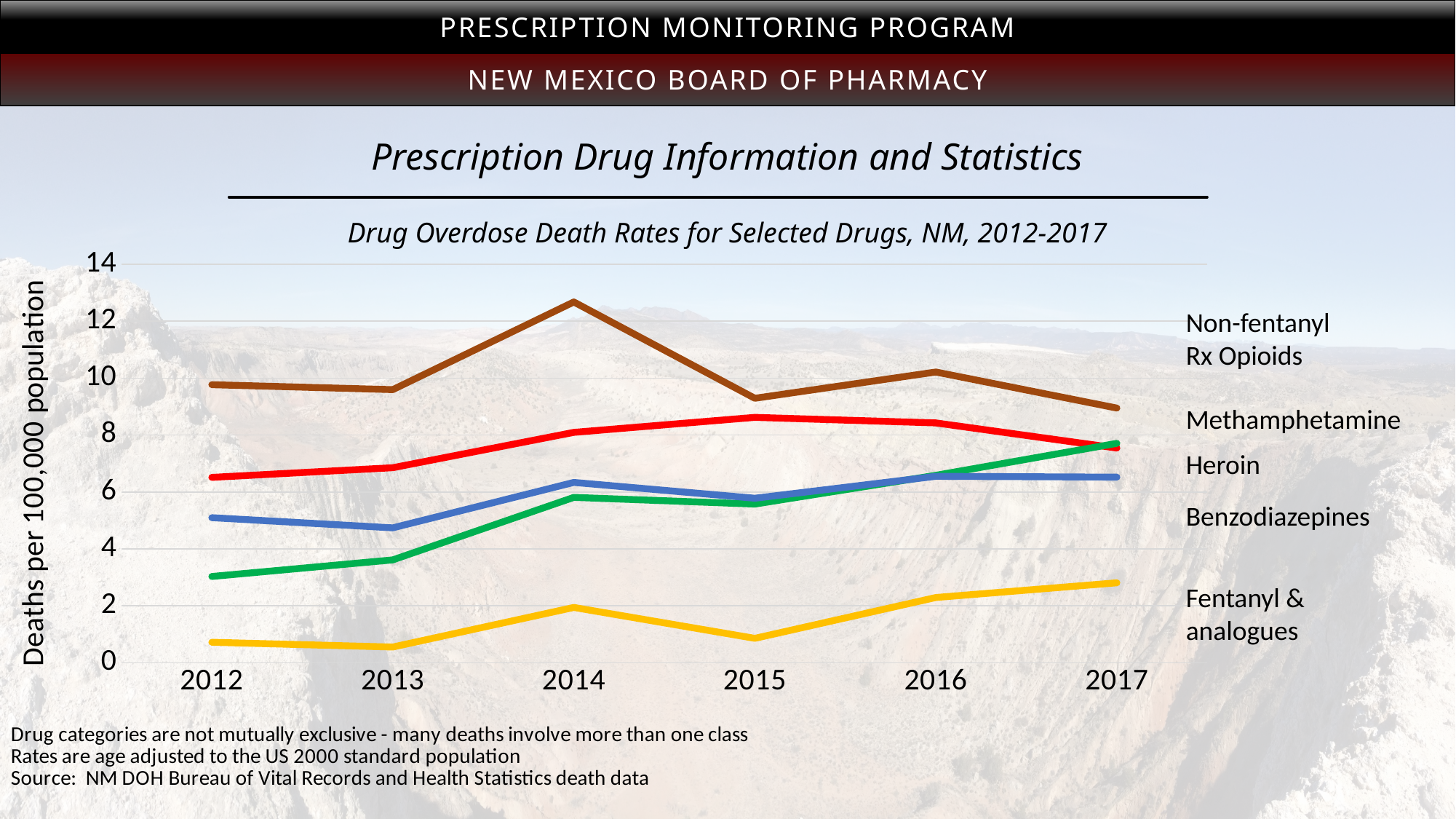
Is the death rate for Fentanyl & analogues in 2013 greater or less than 2? less Which drug category has the highest death rate in 2014? Non-fentanyl Rx Opioids What is the label of the y axis? Deaths per 100,000 population What kind of chart is shown on the slide? Line chart Is the death rate for Heroin in 2015 greater or less than 8? greater Is the death rate for Non-fentanyl Rx Opioids in 2014 greater or less than 12? greater How many years are shown along the x axis? 6 In 2017, which is larger: the death rate for Non-fentanyl Rx Opioids or for Fentanyl & analogues? Non-fentanyl Rx Opioids What is the title of the chart? Drug Overdose Death Rates for Selected Drugs, NM, 2012-2017 Which drug category has the lowest death rate in 2012? Fentanyl & analogues How many drug categories (series) are plotted on the chart? 5 Does the death rate for Methamphetamine rise or fall from 2012 to 2017? Rise